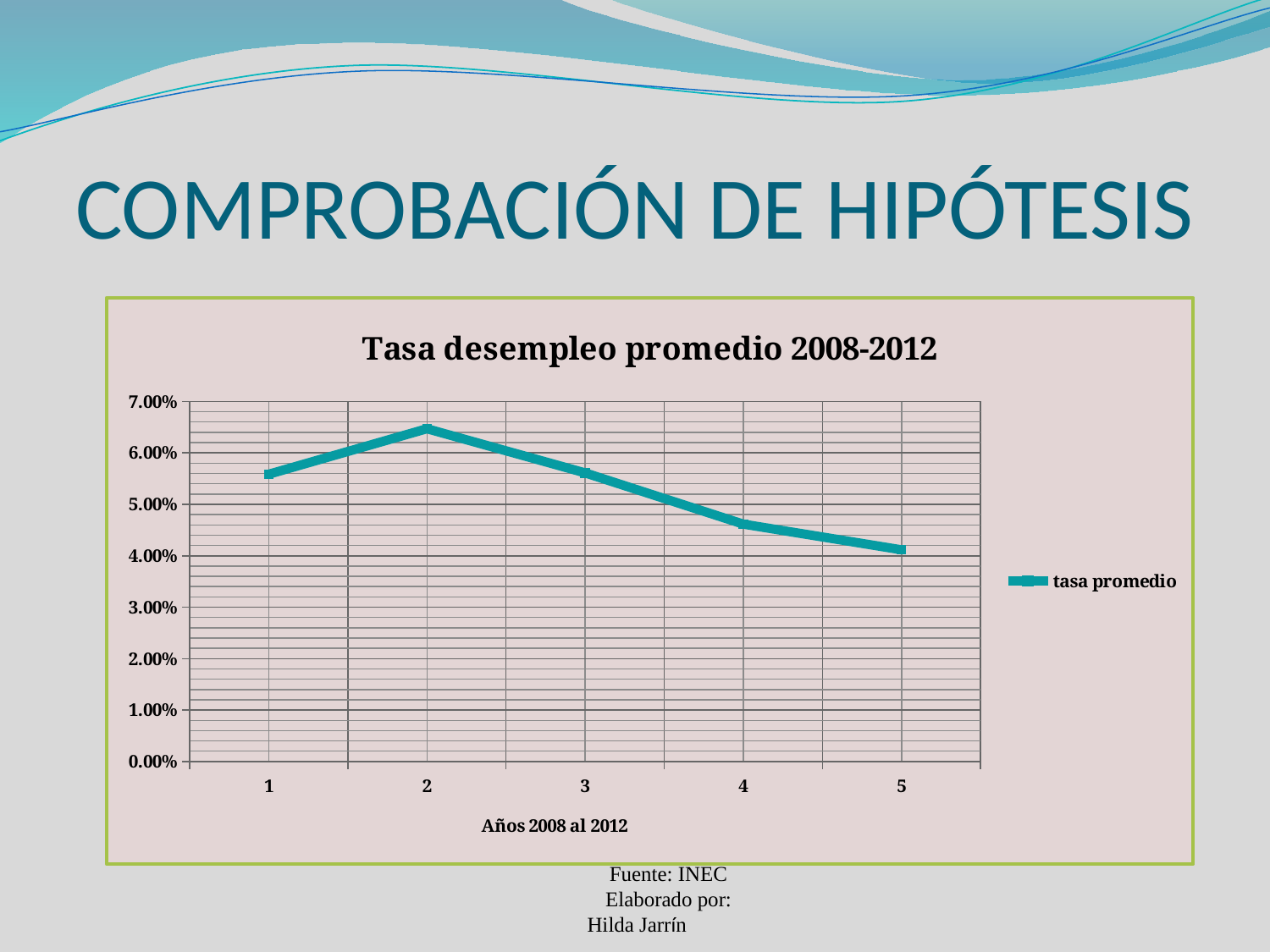
Do the values rise or fall from category 2 to category 5? fall Is the value for category 2 greater or less than 6.00%? greater What series name is listed in the chart legend? tasa promedio What kind of chart is shown on the slide? line chart Is the value for category 1 greater or less than 6.00%? less How many points are plotted along the x axis? 5 At which x-axis category is the tasa promedio lowest? 5 How many series does the legend list? 1 Is the value for category 4 greater or less than 5.00%? less At which x-axis category is the tasa promedio highest? 2 Which has the larger value, category 2 or category 4? 2 What is the title of the chart? Tasa desempleo promedio 2008-2012